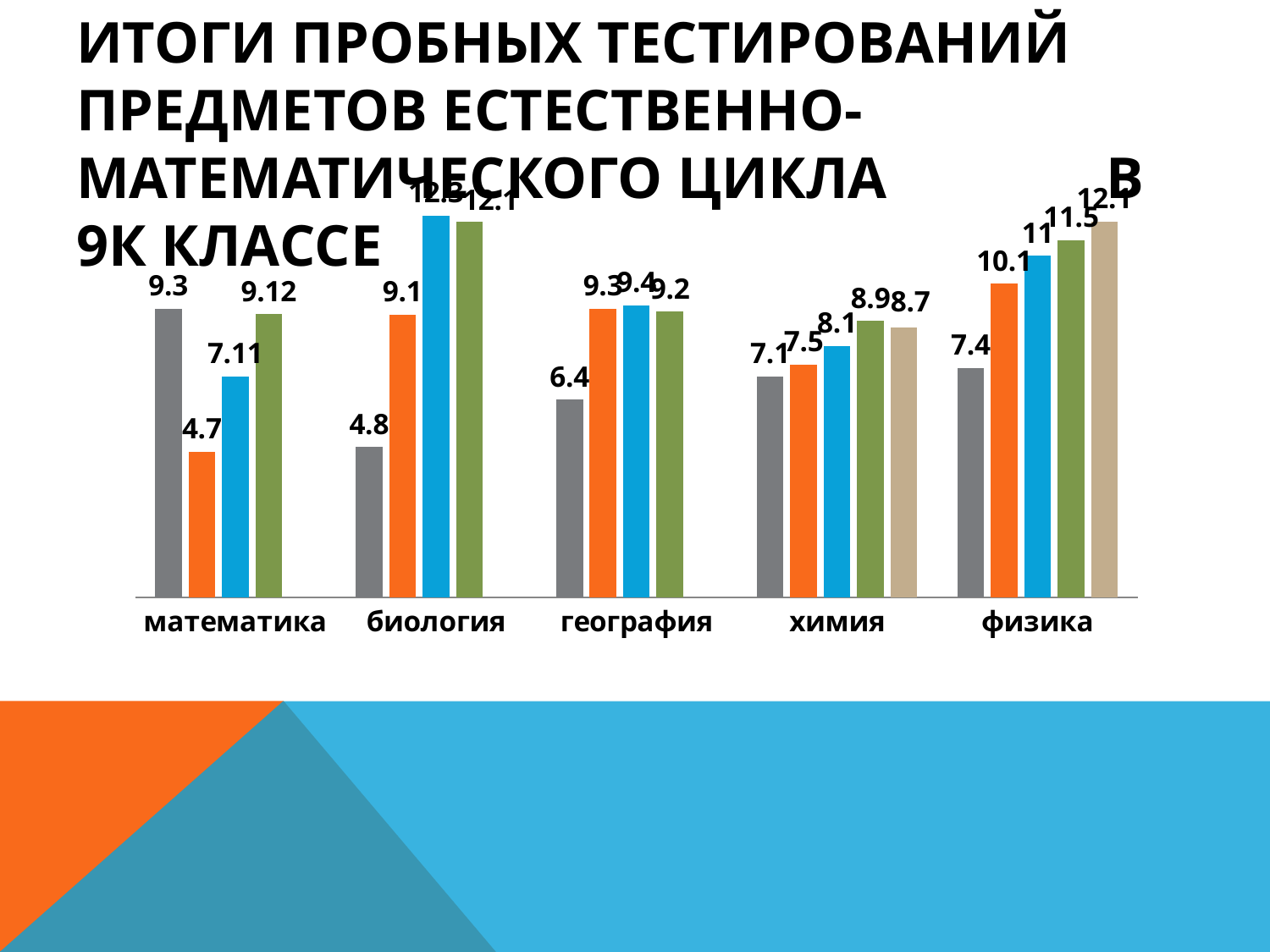
How many bars are shown for the химия category? 5 Which category has the highest gray bar? математика How many subject categories are shown on the x axis of the chart? 5 What is the value of the green bar for химия? 8.9 What is the value of the gray bar for математика? 9.3 What is the difference between the gray bar and the orange bar for математика? 4.6 For химия, which is larger: the blue bar or the green bar? the green bar Which bar is the lowest within the физика category? the gray bar (7.4) What is the value of the gray bar for география? 6.4 What is the value of the orange bar for физика? 10.1 What is the value of the orange bar for математика? 4.7 What kind of chart is shown on the slide? bar chart